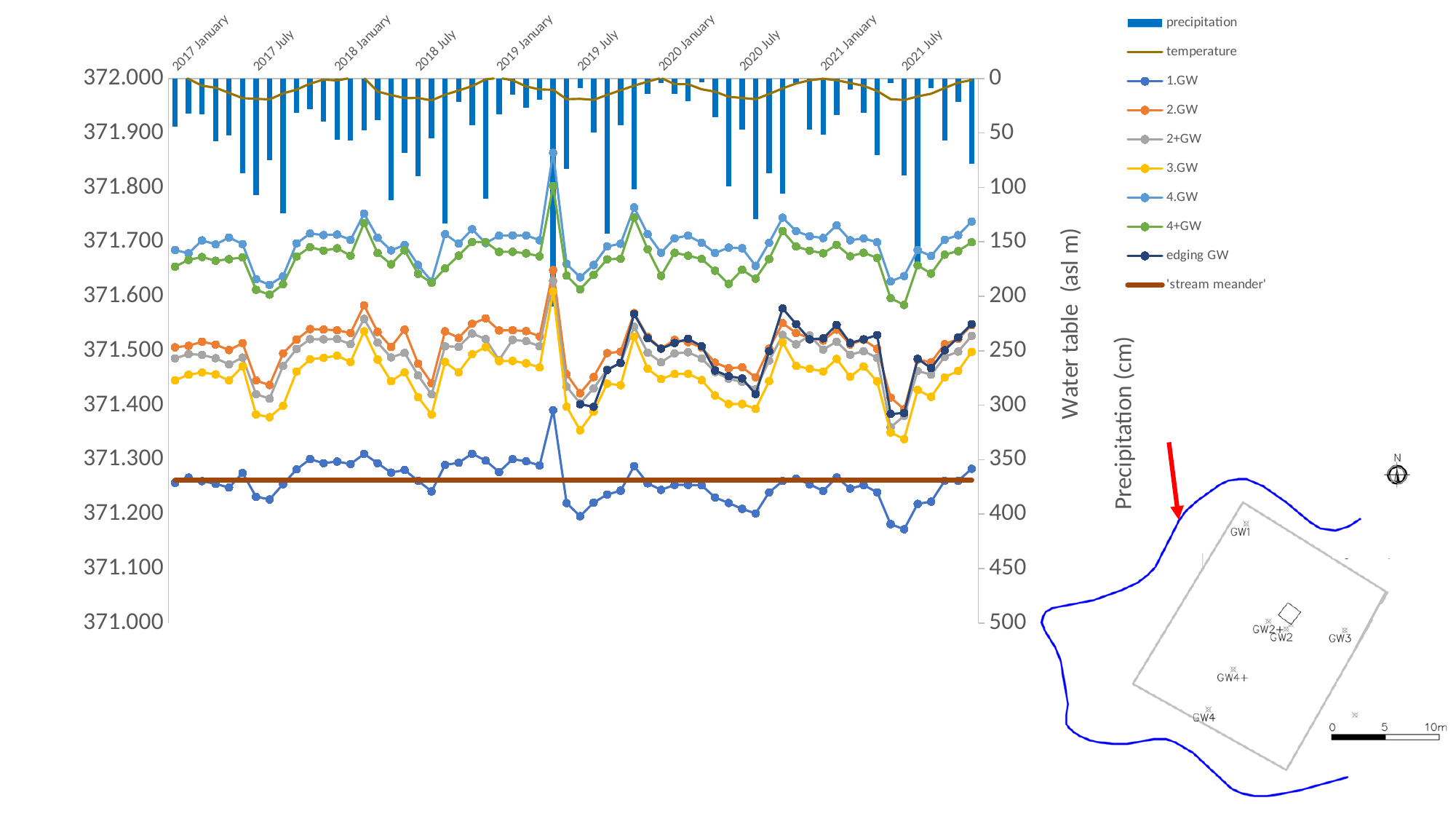
Is the value for 4.GW at 2017 January greater or less than 371.600? greater What is the title of the right-hand vertical axis of the chart? Precipitation (cm) What kind of chart is shown on the slide? A combination bar and line chart Is the value for 2.GW at 2017 January greater or less than 371.600? less How many date labels are shown along the x axis of the chart? 10 Which GW series has the lowest water table values across the whole chart? 1.GW Is the value of the 'stream meander' line greater or less than 371.200? greater At 2017 January, which series has the higher value, 2.GW or 3.GW? 2.GW Which series in the chart is plotted as bars? precipitation How many series does the chart's legend list? 10